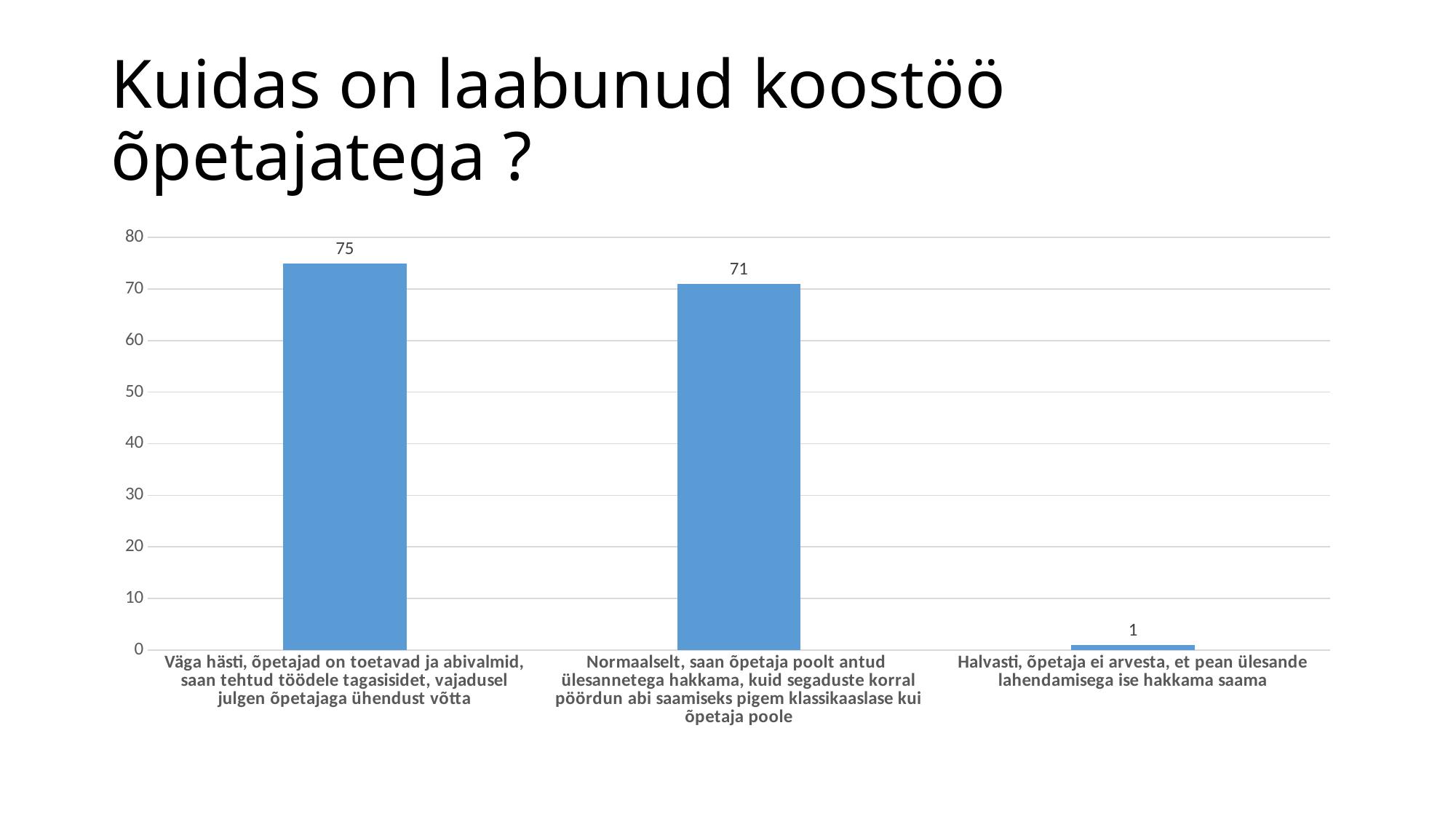
What is the value for the category "Halvasti, õpetaja ei arvesta, et pean ülesande lahendamisega ise hakkama saama"? 1 What is the value for the category "Väga hästi, õpetajad on toetavad ja abivalmid, saan tehtud töödele tagasisidet, vajadusel julgen õpetajaga ühendust võtta"? 75 What is the difference between the values for "Väga hästi..." and "Normaalselt..."? 4 Which category has the lowest value? Halvasti, õpetaja ei arvesta, et pean ülesande lahendamisega ise hakkama saama How many categories are shown on the chart? 3 What is the title of the slide? Kuidas on laabunud koostöö õpetajatega ? Which category has the highest value? Väga hästi, õpetajad on toetavad ja abivalmid, saan tehtud töödele tagasisidet, vajadusel julgen õpetajaga ühendust võtta What is the value for the category "Normaalselt, saan õpetaja poolt antud ülesannetega hakkama, kuid segaduste korral pöördun abi saamiseks pigem klassikaaslase kui õpetaja poole"? 71 What is the difference between the values for "Normaalselt..." and "Halvasti..."? 70 What kind of chart is shown on the slide? bar chart Is the value for "Normaalselt..." greater or less than 60? greater Which is larger: the value for "Väga hästi..." or the value for "Halvasti..."? Väga hästi...